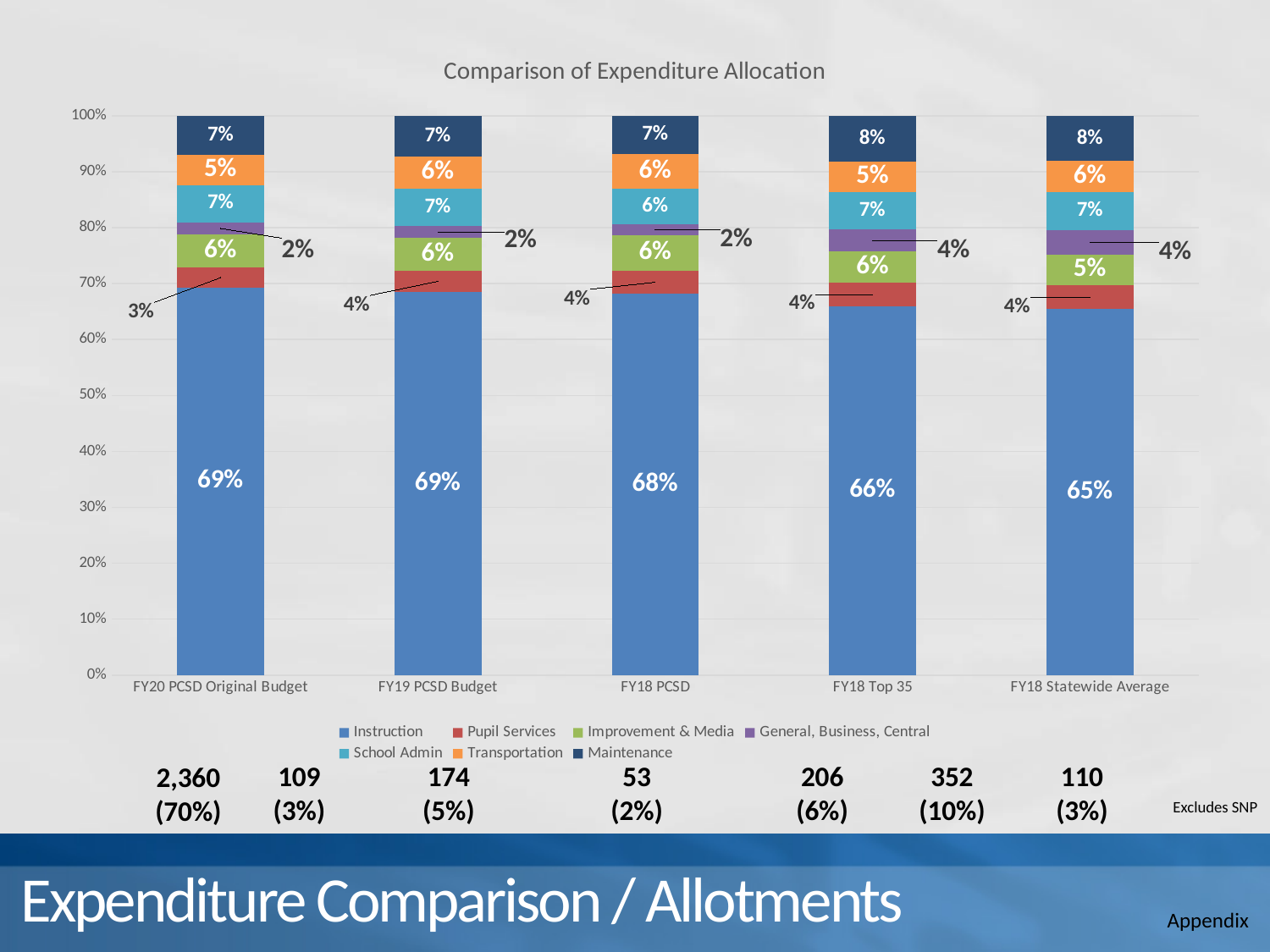
How many series does the legend list? 7 What is the Transportation share for FY19 PCSD Budget? 6% What is the title of the chart? Comparison of Expenditure Allocation What is the Maintenance share for FY18 Top 35? 8% What is the Instruction share for FY18 Statewide Average? 65% Which category has the lowest Instruction share? FY18 Statewide Average What type of chart is shown on the slide? Stacked bar chart What is the Pupil Services share for FY20 PCSD Original Budget? 3% Does the Instruction share rise or fall from FY20 PCSD Original Budget to FY18 Statewide Average across the x axis? Fall How many categories are shown on the x axis? 5 What is the difference between the Instruction share for FY20 PCSD Original Budget and FY18 Statewide Average? 4% Which is larger, the General, Business, Central share for FY18 PCSD or for FY18 Top 35? FY18 Top 35